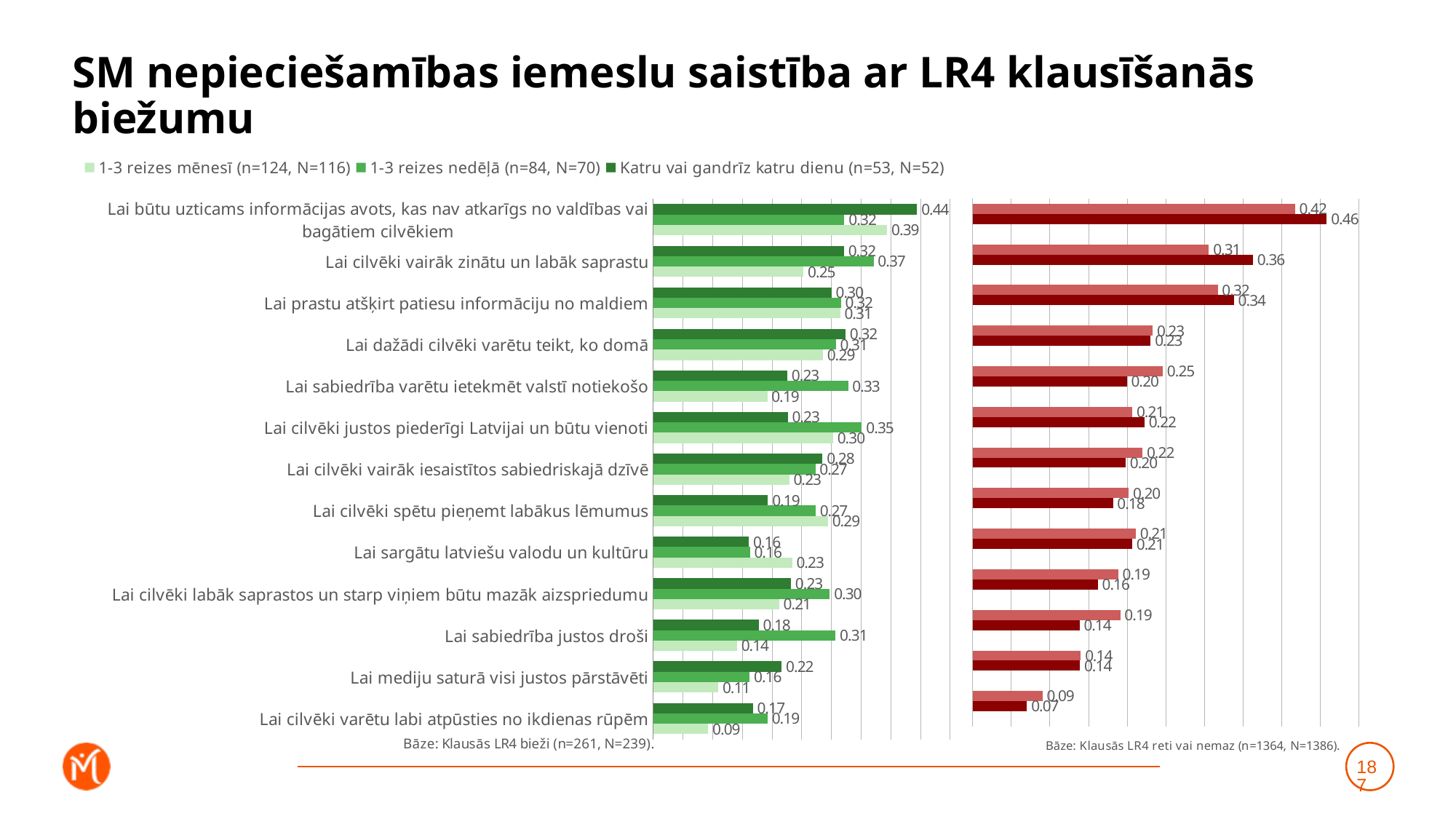
What kind of chart is the left (green) chart? Bar chart On the right (red) chart, what is the value of the dark red bar for 'Lai cilvēki varētu labi atpūsties no ikdienas rūpēm'? 0.07 On the left (green) chart, which category has the lowest value for '1-3 reizes mēnesī'? Lai cilvēki varētu labi atpūsties no ikdienas rūpēm On the left (green) chart, for 'Lai cilvēki vairāk zinātu un labāk saprastu', which is larger: '1-3 reizes nedēļā' or '1-3 reizes mēnesī'? 1-3 reizes nedēļā On the left (green) chart, what is the difference between the '1-3 reizes nedēļā' and 'Katru vai gandrīz katru dienu' values for 'Lai sabiedrība justos droši'? 0.13 How many categories are shown on the left (green) chart? 13 On the left (green) chart, what is the value for 'Katru vai gandrīz katru dienu' for 'Lai būtu uzticams informācijas avots, kas nav atkarīgs no valdības vai bagātiem cilvēkiem'? 0.44 On the left (green) chart, what is the value for '1-3 reizes mēnesī' for 'Lai cilvēki varētu labi atpūsties no ikdienas rūpēm'? 0.09 On the right (red) chart, what is the value of the dark red bar for 'Lai būtu uzticams informācijas avots, kas nav atkarīgs no valdības vai bagātiem cilvēkiem'? 0.46 On the left (green) chart, which category has the highest value for 'Katru vai gandrīz katru dienu'? Lai būtu uzticams informācijas avots, kas nav atkarīgs no valdības vai bagātiem cilvēkiem How many series does the legend of the left (green) chart list? 3 On the left (green) chart, what is the value for '1-3 reizes nedēļā' for 'Lai sabiedrība justos droši'? 0.31